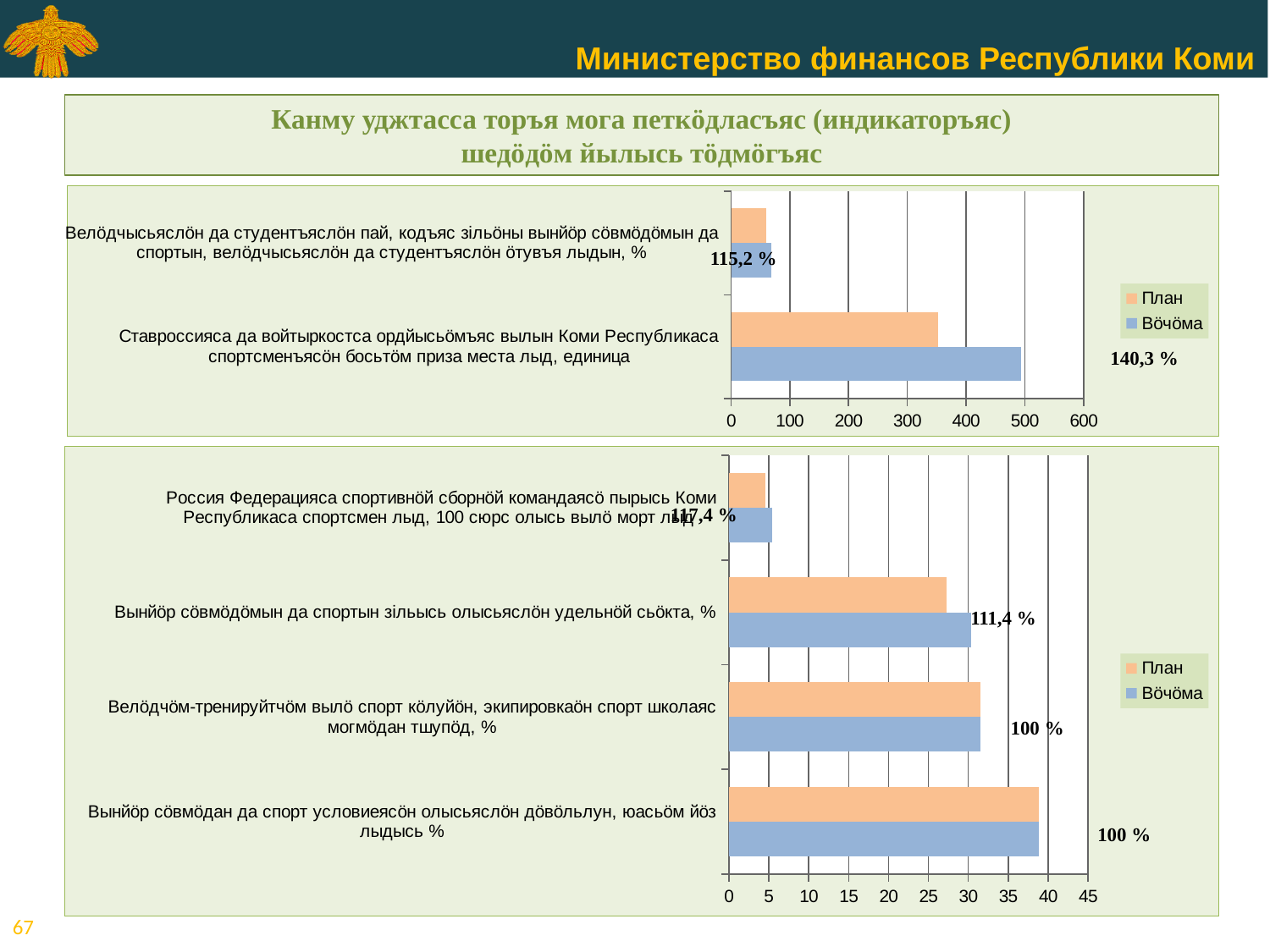
In the top chart, is the Вöчöма value for 'Ставроссияса да войтыркостса ордйысьöмъяс вылын Коми Республикаса спортсменъясöн босьтöм приза места лыд, единица' greater or less than 400? greater In the bottom chart, which category has the lowest values? Россия Федерацияса спортивнöй сборнöй командаясö пырысь Коми Республикаса спортсмен лыд, 100 сюрс олысь вылö морт лыд In the top chart, for 'Ставроссияса да войтыркостса ордйысьöмъяс вылын Коми Республикаса спортсменъясöн босьтöм приза места лыд, единица', which is larger: План or Вöчöма? Вöчöма In the top chart, how many series does the legend list? 2 In the top chart, what percentage label is printed next to the bars for 'Ставроссияса да войтыркостса ордйысьöмъяс вылын Коми Республикаса спортсменъясöн босьтöм приза места лыд, единица'? 140,3 % In the top chart, how many categories are plotted? 2 In the top chart, which category has the highest values? Ставроссияса да войтыркостса ордйысьöмъяс вылын Коми Республикаса спортсменъясöн босьтöм приза места лыд, единица In the bottom chart, for 'Вынйöр сöвмöдöмын да спортын зільысь олысьяслöн удельнöй сьöкта, %', which is larger: План or Вöчöма? Вöчöма In the top chart, what kind of chart is shown? bar chart In the bottom chart, how many categories are plotted? 4 In the bottom chart, what percentage label is printed next to the bars for 'Вынйöр сöвмöдöмын да спортын зільысь олысьяслöн удельнöй сьöкта, %'? 111,4 % In the bottom chart, is the План value for 'Вынйöр сöвмöдан да спорт условиеясöн олысьяслöн дöвöльлун, юасьöм йöз лыдысь %' greater or less than 35? greater